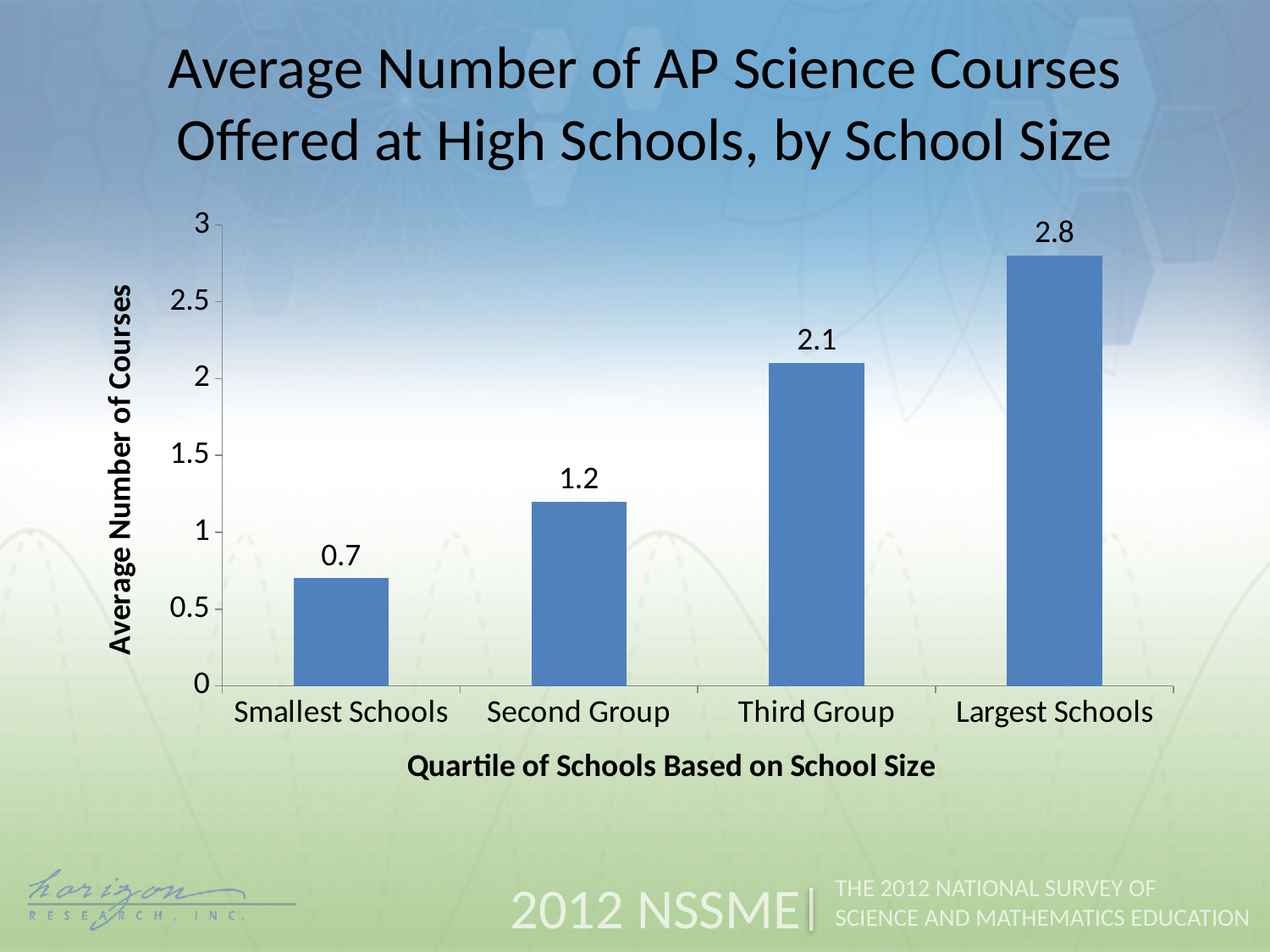
Do the values rise or fall as school size increases from Smallest Schools to Largest Schools? Rise What kind of chart is shown on the slide? Bar chart What is the average number of AP science courses offered at the Largest Schools? 2.8 What is the average number of AP science courses offered at the Smallest Schools? 0.7 Which has a higher average number of AP science courses, the Second Group or the Third Group? Third Group Which quartile of schools has the highest average number of AP science courses? Largest Schools What is the average number of AP science courses offered at the Third Group of schools? 2.1 What is the difference in average number of AP science courses between the Largest Schools and the Smallest Schools? 2.1 Which quartile of schools has the lowest average number of AP science courses? Smallest Schools What is the difference in average number of AP science courses between the Third Group and the Second Group? 0.9 What is the average number of AP science courses offered at the Second Group of schools? 1.2 How many quartiles of schools are shown on the x axis? 4